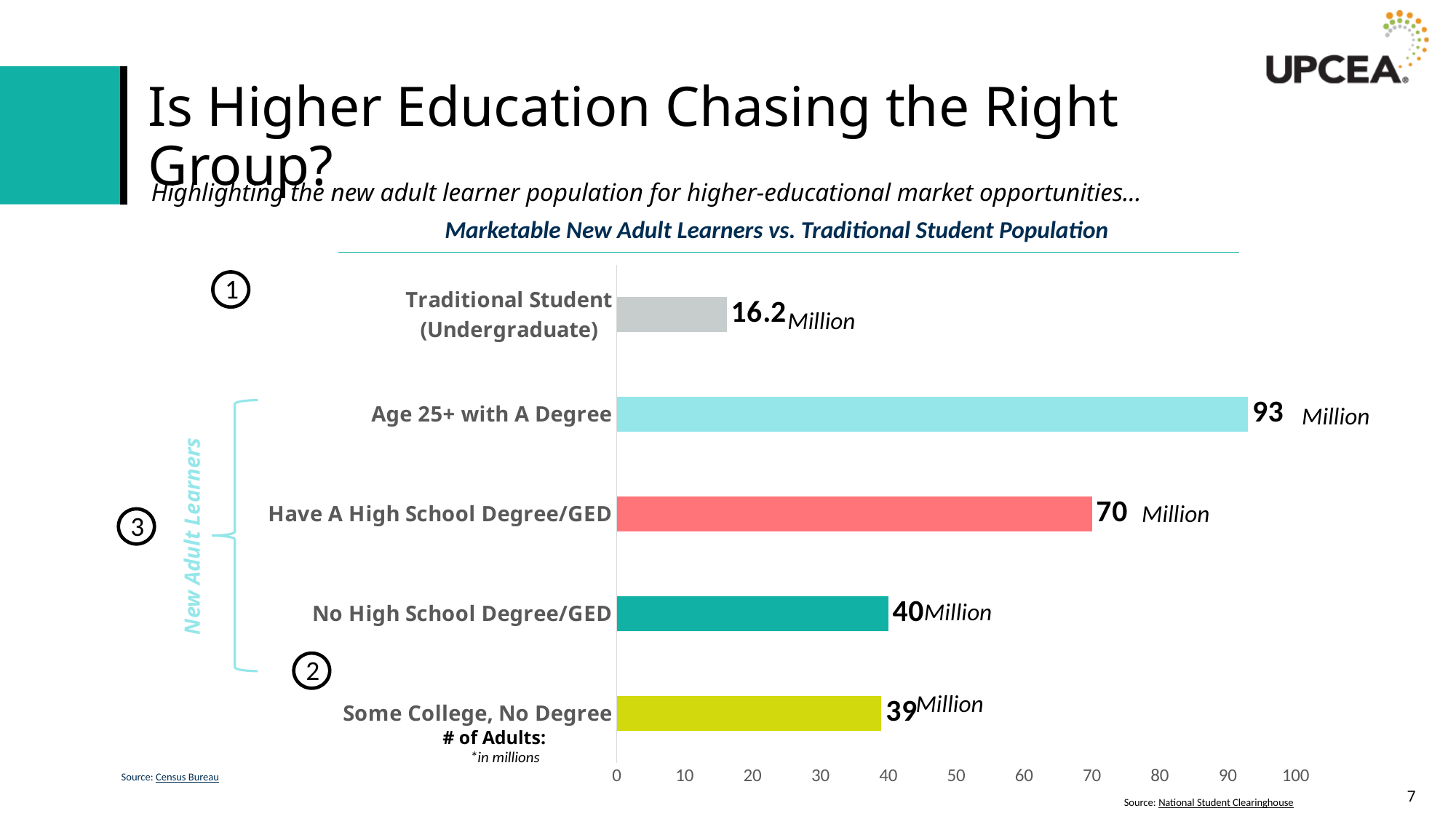
What is the value for Age 25+ with A Degree? 93 Million What is the title of the chart? Marketable New Adult Learners vs. Traditional Student Population What kind of chart is shown on the slide? Bar chart Is the value for Age 25+ with A Degree greater or less than 90? greater How many categories are shown in the chart? 5 What is the value for Some College, No Degree? 39 Million Which category has the highest value? Age 25+ with A Degree Which category has the lowest value? Traditional Student (Undergraduate) What is the difference between Have A High School Degree/GED and No High School Degree/GED? 30 Million What is the difference between Age 25+ with A Degree and Traditional Student (Undergraduate)? 76.8 Million Which is larger, Have A High School Degree/GED or Some College, No Degree? Have A High School Degree/GED What is the value for Traditional Student (Undergraduate)? 16.2 Million